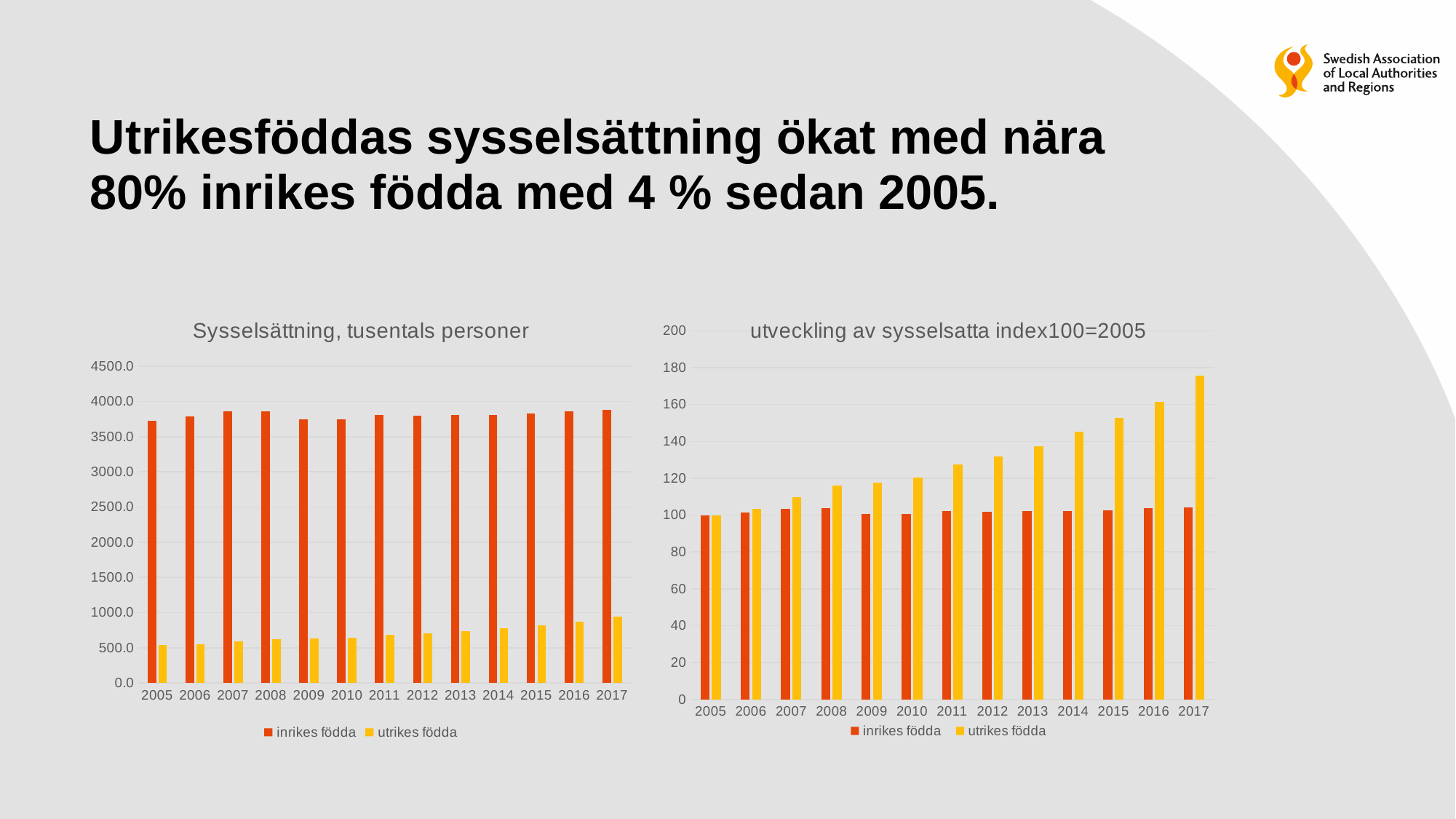
In the right chart 'utveckling av sysselsatta index100=2005', in which year is the utrikes födda index highest? 2017 In the right chart 'utveckling av sysselsatta index100=2005', what is the index value for inrikes födda in 2005? 100 In the right chart 'utveckling av sysselsatta index100=2005', which series has the larger value in 2017, inrikes födda or utrikes födda? utrikes födda In the right chart 'utveckling av sysselsatta index100=2005', does the utrikes födda index rise or fall from 2005 to 2017? rise How many years are shown on the x axis of the right chart 'utveckling av sysselsatta index100=2005'? 13 In the left chart 'Sysselsättning, tusentals personer', is the value for inrikes födda in 2005 greater or less than 3500.0? greater What is the title of the left chart? Sysselsättning, tusentals personer In the right chart 'utveckling av sysselsatta index100=2005', is the value for utrikes födda in 2017 greater or less than 160? greater In the left chart 'Sysselsättning, tusentals personer', in which year is the utrikes födda value lowest? 2005 What kind of chart is the left chart titled 'Sysselsättning, tusentals personer'? bar chart How many series does the legend of the left chart 'Sysselsättning, tusentals personer' list? 2